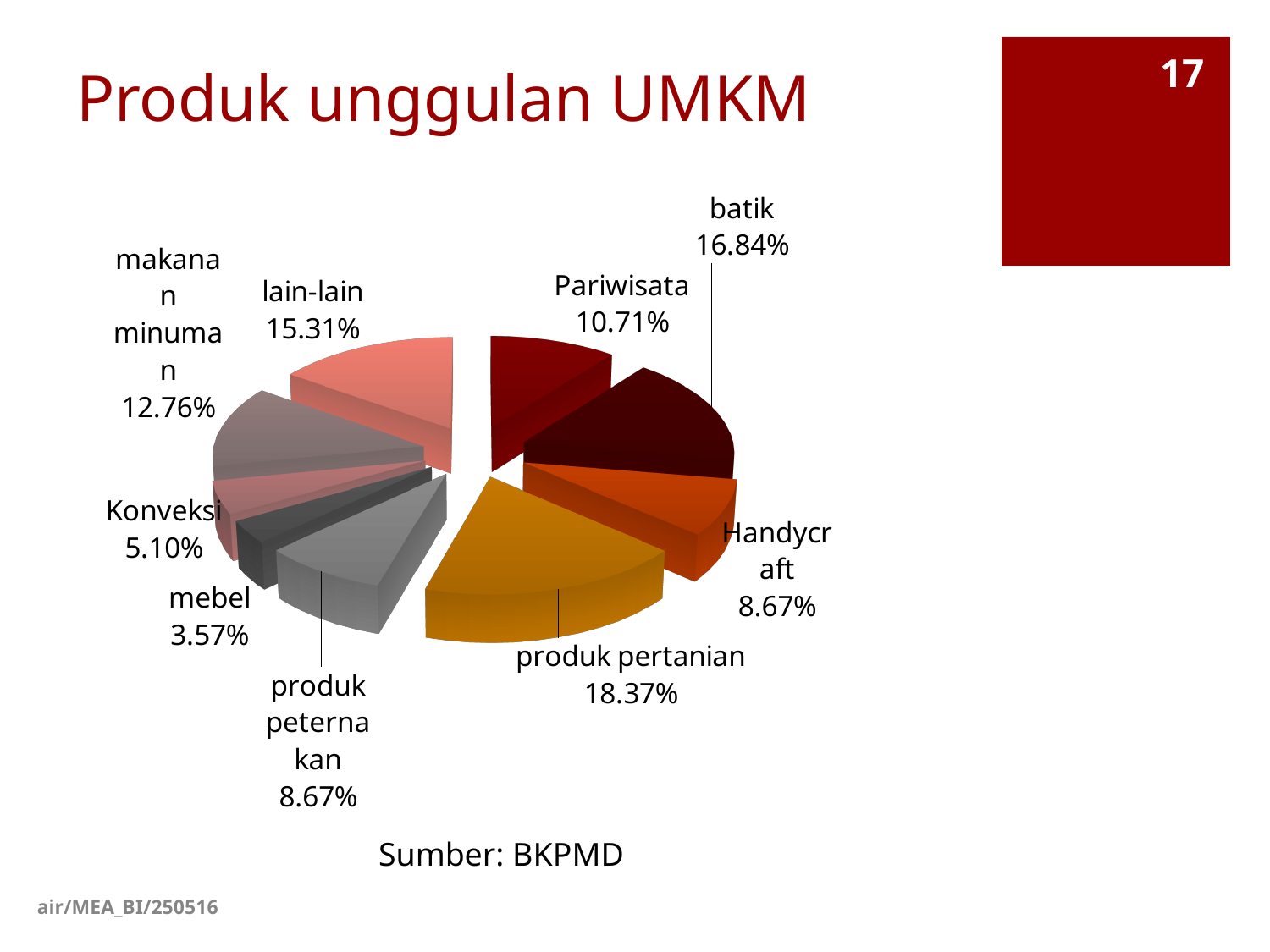
What is the value shown for makanan minuman? 12.76% What is the title of the chart on the slide? Produk unggulan UMKM What type of chart is shown on the slide? pie chart Which is larger, the share for Pariwisata or the share for Handycraft? Pariwisata What is the value shown for batik? 16.84% Which category has the largest share of the pie? produk pertanian What percentage is shown for Konveksi? 5.10% What is the difference between the shares of produk pertanian and mebel? 14.80% How many categories are shown in the pie chart? 9 What share of the pie does produk pertanian have? 18.37% What is the difference between the shares of batik and lain-lain? 1.53% Which category has the smallest share of the pie? mebel